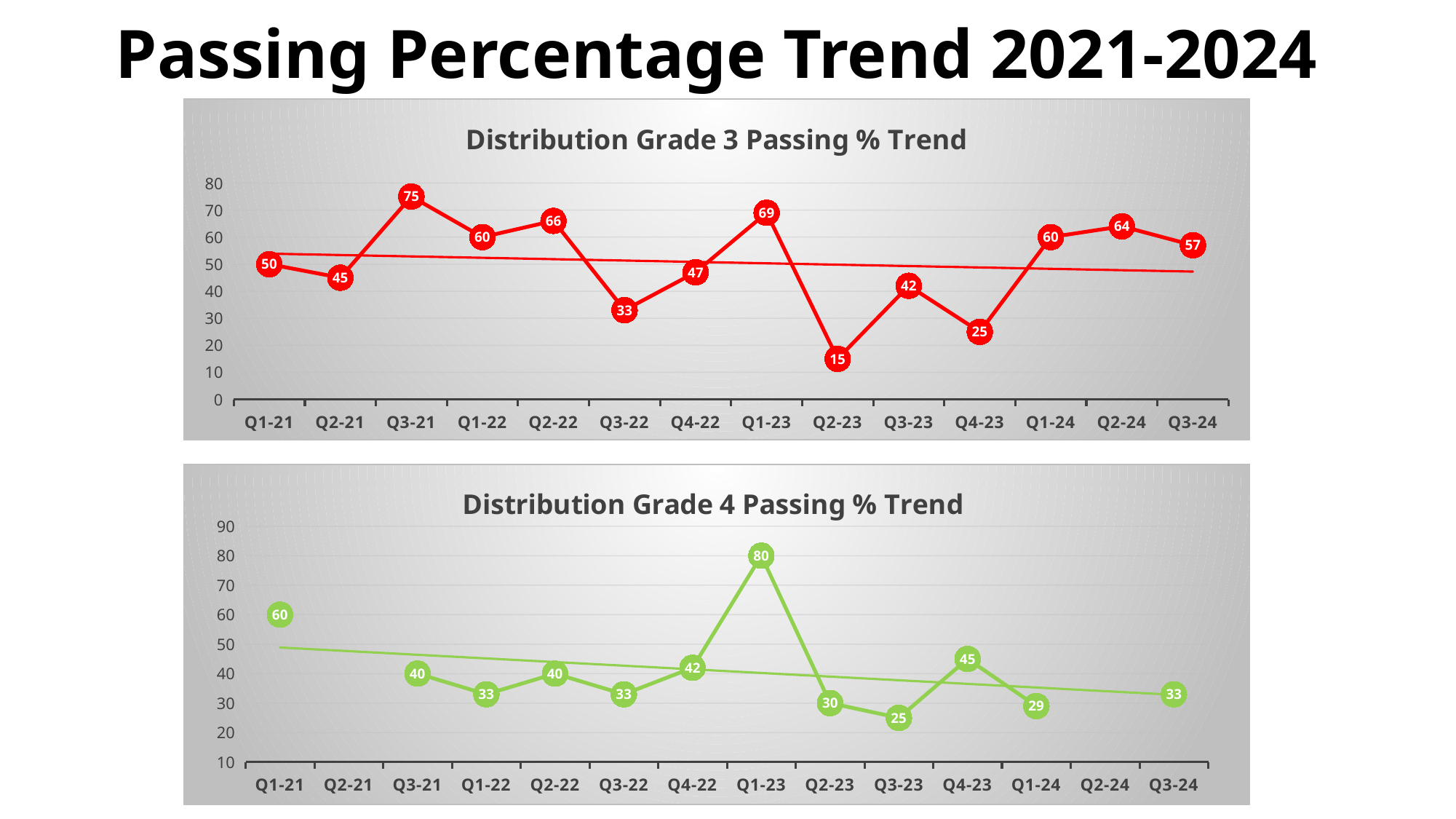
In the Distribution Grade 4 Passing % Trend chart, what is the value for Q1-23? 80 In the Distribution Grade 3 Passing % Trend chart, which is larger, the value for Q2-24 or the value for Q3-24? Q2-24 In the Distribution Grade 4 Passing % Trend chart, what is the difference between the values for Q1-21 and Q3-24? 27 In the Distribution Grade 4 Passing % Trend chart, which quarter has the lowest plotted value? Q3-23 In the Distribution Grade 3 Passing % Trend chart, which quarter has the lowest value? Q2-23 In the Distribution Grade 3 Passing % Trend chart, which quarter has the highest value? Q3-21 What kind of chart is the Distribution Grade 4 Passing % Trend chart? Line chart What colour are the data markers in the Distribution Grade 3 Passing % Trend chart? Red In the Distribution Grade 3 Passing % Trend chart, what is the difference between the values for Q1-23 and Q2-23? 54 In the Distribution Grade 3 Passing % Trend chart, what is the value for Q3-21? 75 In the Distribution Grade 3 Passing % Trend chart, how many quarters are shown on the x axis? 14 In the Distribution Grade 4 Passing % Trend chart, what is the value for Q4-23? 45